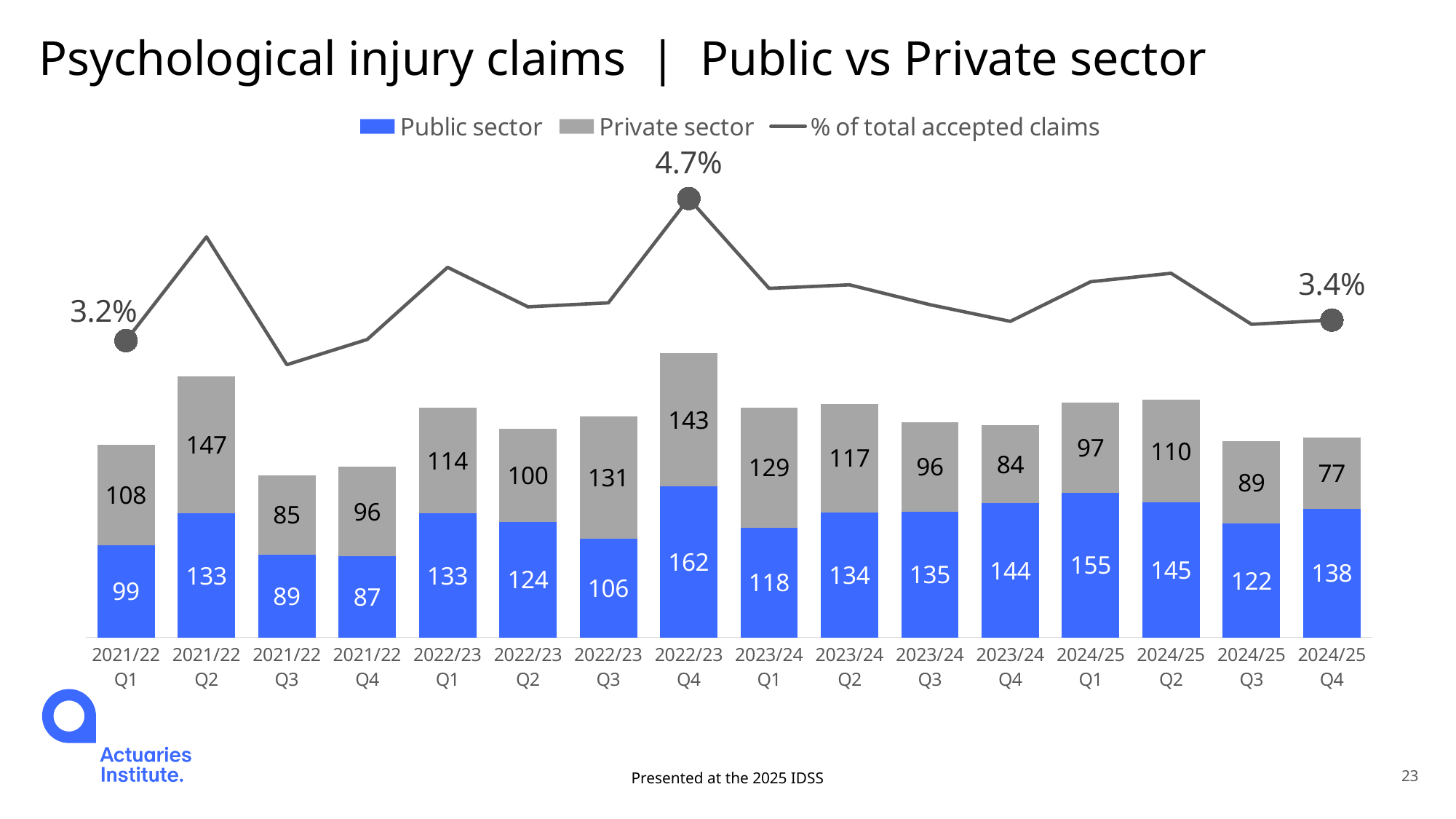
Which quarter has the highest Public sector value? 2022/23 Q4 What is the Public sector value for 2022/23 Q4? 162 How many quarters are shown on the x axis? 16 What kind of chart is shown on the slide? A stacked bar chart with a line What is the Private sector value for 2021/22 Q2? 147 Which is larger, the Private sector value for 2022/23 Q3 or for 2023/24 Q1? 2022/23 Q3 What is the % of total accepted claims value labelled at 2022/23 Q4? 4.7% What is the total of the stacked bar for 2021/22 Q1? 207 How many series does the legend list? 3 What is the total of the stacked bar for 2024/25 Q4? 215 Which quarter has the lowest Private sector value? 2024/25 Q4 What is the difference between the Public sector values for 2024/25 Q1 and 2024/25 Q3? 33